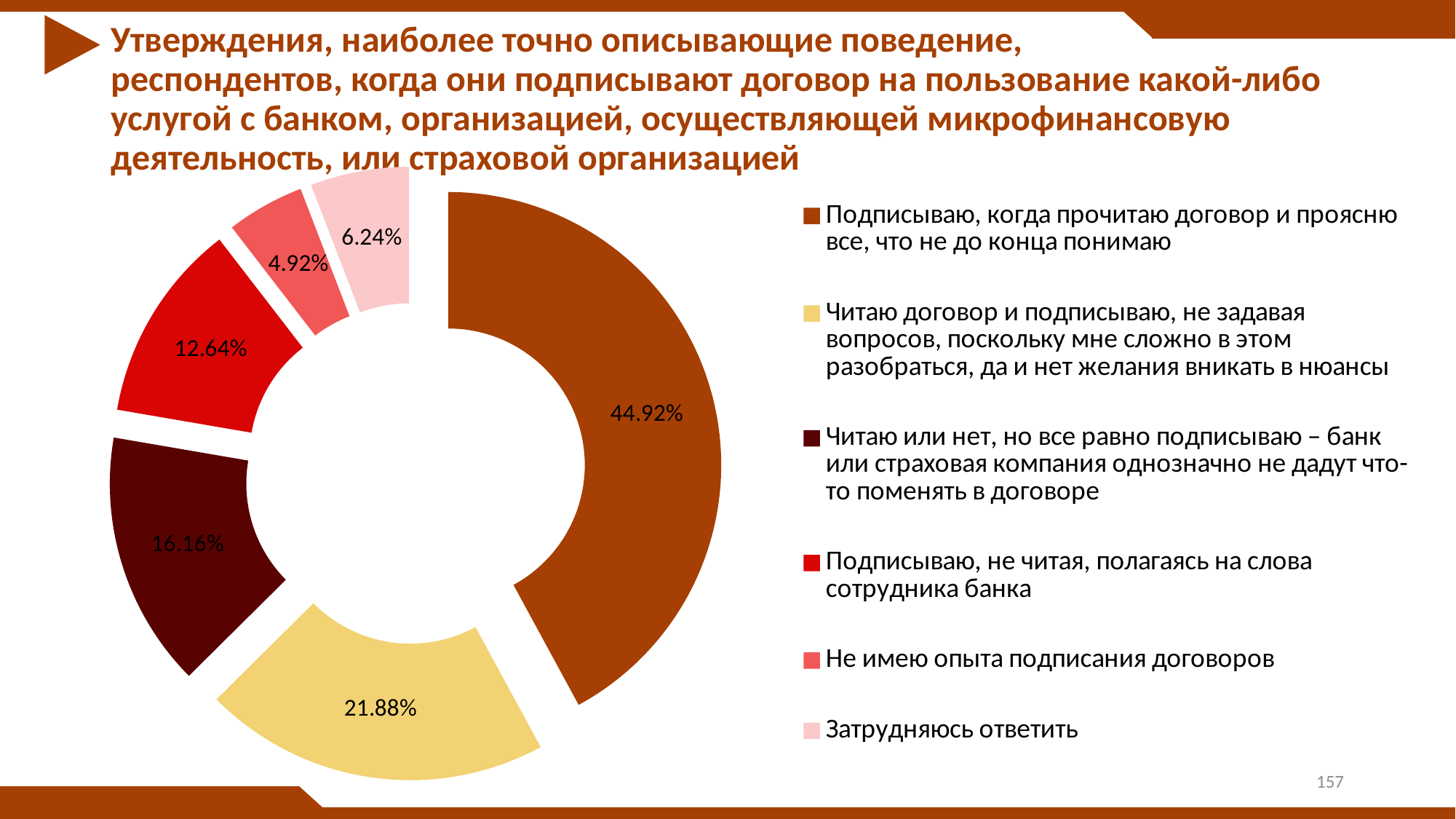
What value is shown for "Подписываю, не читая, полагаясь на слова сотрудника банка"? 12.64% Which response has the smallest share in the chart? Не имею опыта подписания договоров What is the difference in percentage points between the largest slice (44.92%) and the slice for "Читаю договор и подписываю, не задавая вопросов..." (21.88%)? 23.04 Which is larger: the share for "Читаю или нет, но все равно подписываю..." or the share for "Подписываю, не читая, полагаясь на слова сотрудника банка"? Читаю или нет, но все равно подписываю – банк или страховая компания однозначно не дадут что-то поменять в договоре Which response has the largest share in the chart? Подписываю, когда прочитаю договор и проясню все, что не до конца понимаю What percentage of respondents answered "Затрудняюсь ответить"? 6.24% What colour is the slice for "Затрудняюсь ответить"? Light pink How many slices does the chart have? 6 What percentage is shown for "Читаю договор и подписываю, не задавая вопросов, поскольку мне сложно в этом разобраться, да и нет желания вникать в нюансы"? 21.88% What share of respondents chose "Подписываю, когда прочитаю договор и проясню все, что не до конца понимаю"? 44.92% What type of chart is shown on the slide? Doughnut chart What value is shown for "Не имею опыта подписания договоров"? 4.92%